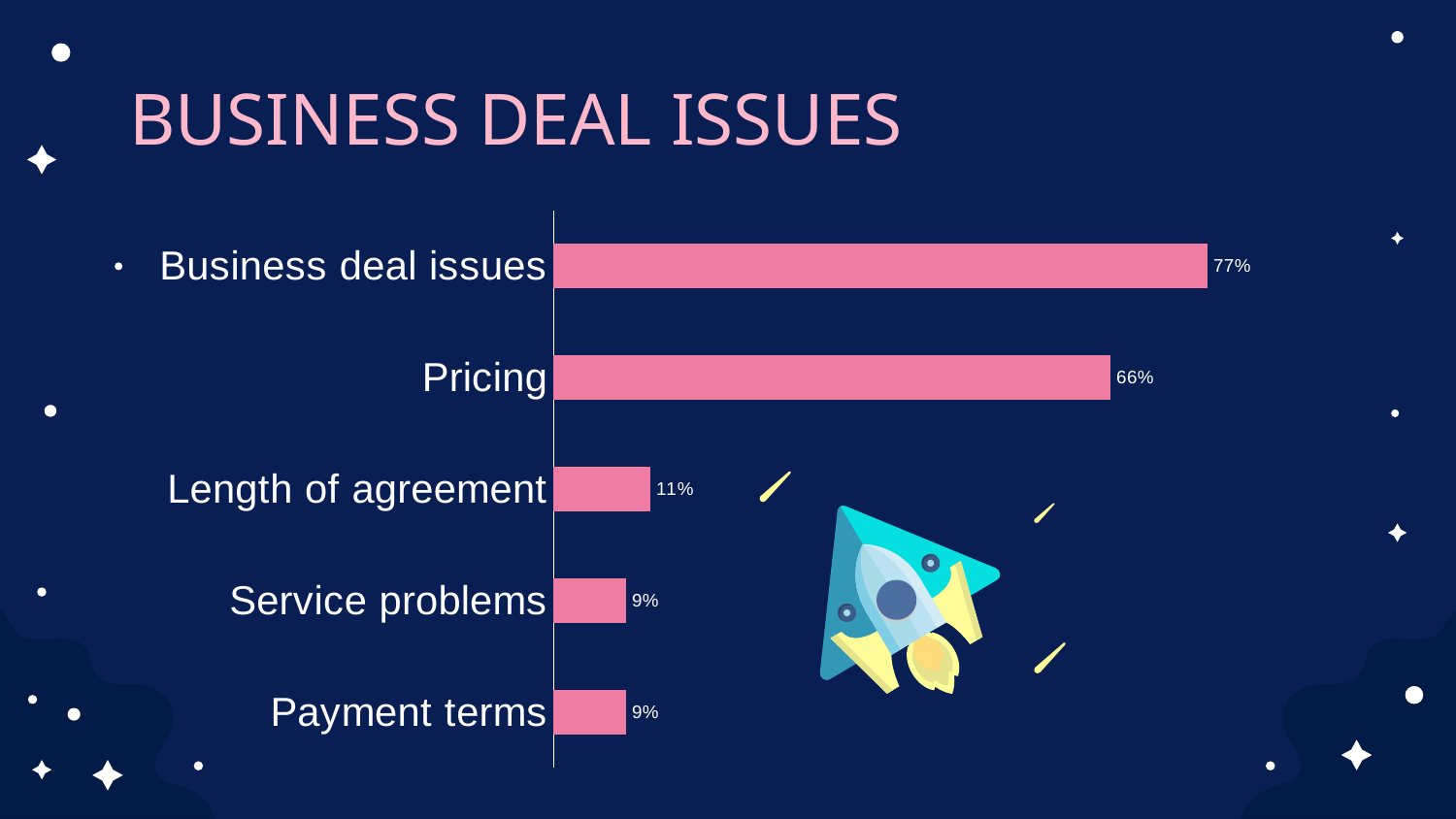
What is the value for Pricing? 66% What is the difference between the values for Business deal issues and Pricing? 11% Which two categories share the same value of 9%? Service problems and Payment terms What is the value for Service problems? 9% What is the difference between the values for Length of agreement and Service problems? 2% Which is larger, the value for Pricing or the value for Length of agreement? Pricing Which category has the highest value? Business deal issues What is the value for Length of agreement? 11% How many categories are shown in the chart? 5 What is the title of the slide containing the chart? BUSINESS DEAL ISSUES What kind of chart is shown on the slide? Bar chart What is the value for Business deal issues? 77%